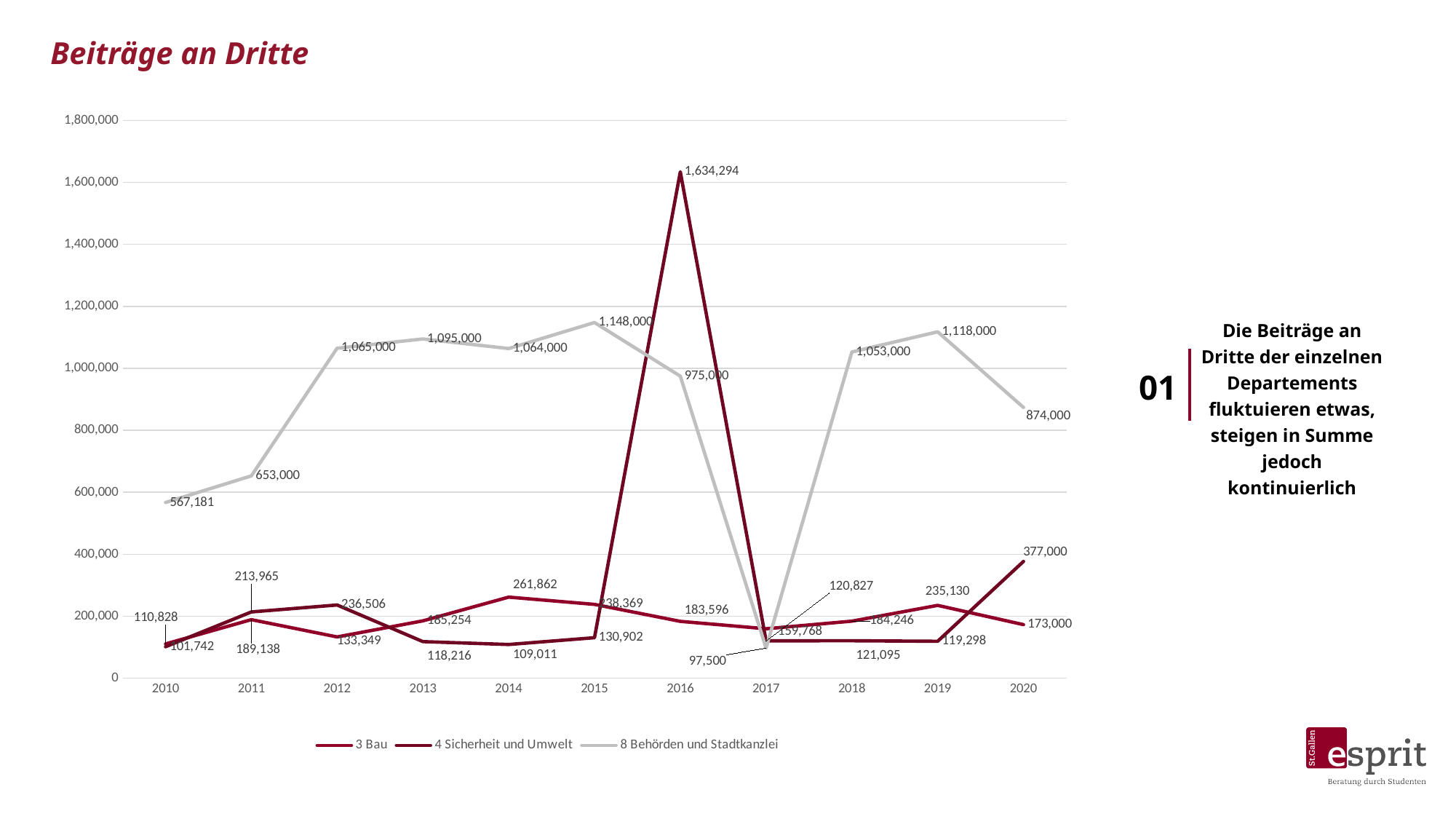
What kind of chart is shown on the slide? line chart What is the value for 4 Sicherheit und Umwelt in 2016? 1,634,294 In which year does 8 Behörden und Stadtkanzlei reach its highest value? 2015 How many years are plotted along the x axis? 11 What is the value for 3 Bau in 2014? 261,862 In which year does 8 Behörden und Stadtkanzlei have its lowest value? 2017 How many series does the legend list? 3 Does the 8 Behörden und Stadtkanzlei line rise or fall from 2010 to 2012? rise What is the difference between the 8 Behörden und Stadtkanzlei values for 2019 and 2020? 244,000 What is the value for 8 Behörden und Stadtkanzlei in 2020? 874,000 In 2020, which series has the larger value: 3 Bau or 4 Sicherheit und Umwelt? 4 Sicherheit und Umwelt What is the title of the chart? Beiträge an Dritte